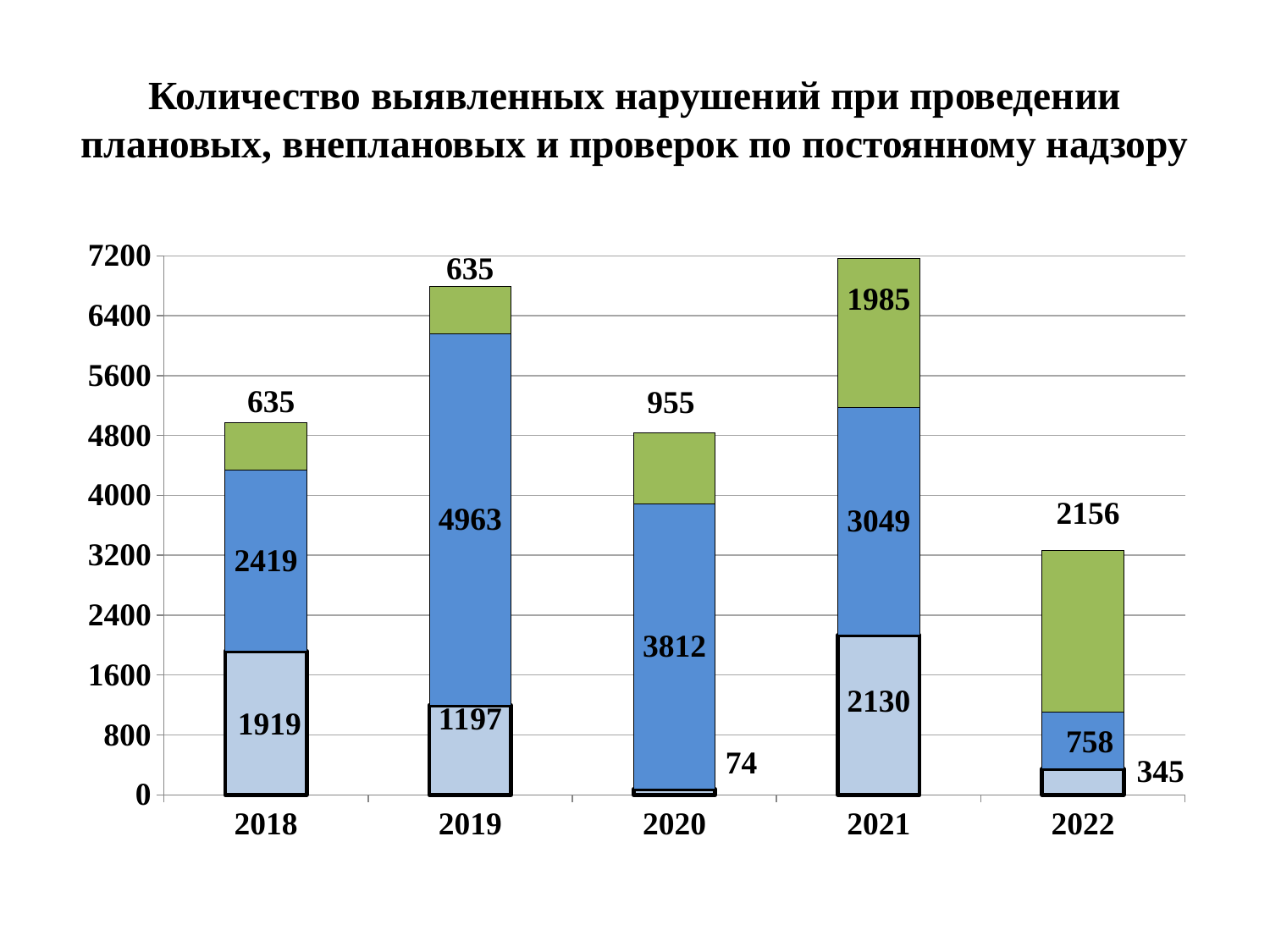
What is the difference between the blue (middle) segment values for 2019 and 2018? 2544 What is the total of the stacked bar for 2022? 3259 What is the total of the stacked bar for 2021? 7164 What is the value of the light blue (bottom) segment for 2020? 74 Which year has the shortest stacked bar overall? 2022 Which year has the tallest stacked bar overall? 2021 What kind of chart is shown on the slide? Stacked bar chart How many years are shown along the x axis of the chart? 5 What is the value of the green (top) segment for 2022? 2156 Which is larger: the green (top) segment for 2022 or for 2021? 2022 What is the value of the light blue (bottom) segment for 2018? 1919 What is the value of the blue (middle) segment for 2019? 4963